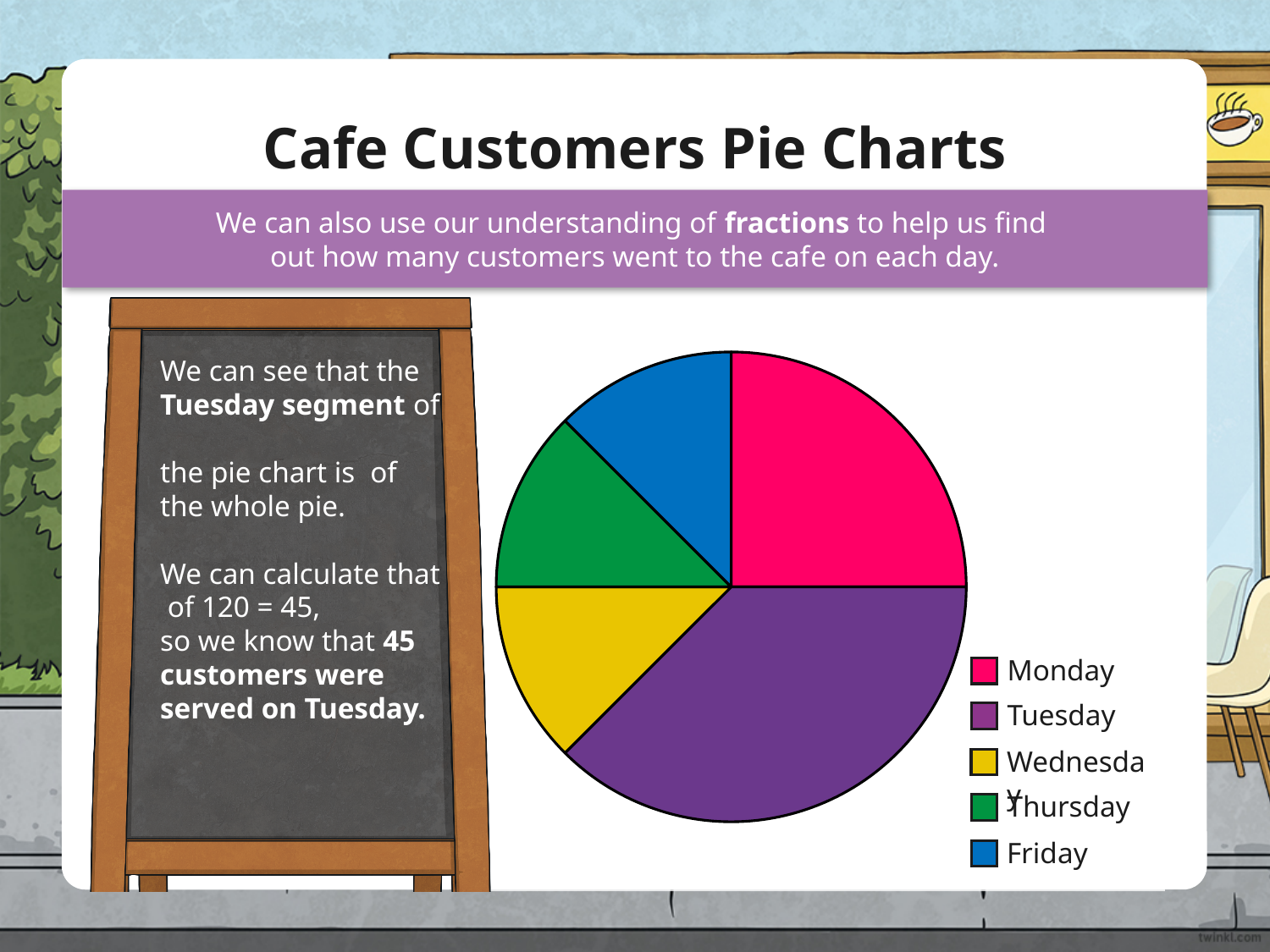
How many categories (days) does the pie chart show? 5 What kind of chart is shown on the slide? pie chart Which slice is larger, Monday or Friday? Monday Which slice is larger, Monday or Tuesday? Tuesday Which slice is larger, Tuesday or Thursday? Tuesday How many entries does the legend list? 5 Which day has the largest slice of the pie chart? Tuesday What colour represents Tuesday in the pie chart? purple According to the slide, what is the total number of customers represented by the whole pie? 120 According to the slide, how many customers were served on Tuesday? 45 What is the title of the slide? Cafe Customers Pie Charts